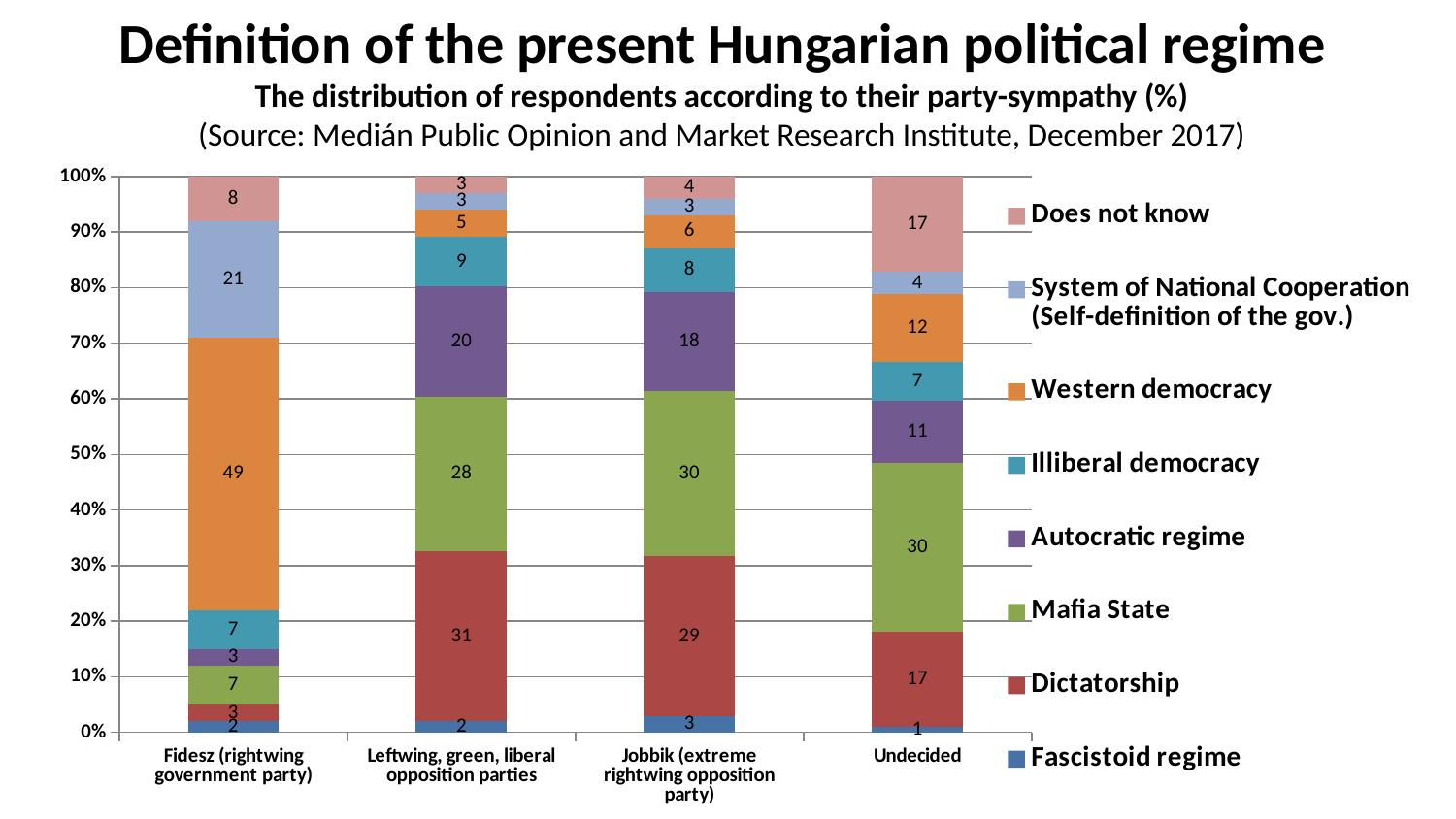
Which is larger: the Dictatorship value for Jobbik (extreme rightwing opposition party) or for Undecided? Jobbik (extreme rightwing opposition party) What kind of chart is shown on the slide? Stacked bar chart Which legend entry is shown in green? Mafia State Which category has the lowest value for Fascistoid regime? Undecided What is the value for Dictatorship among Leftwing, green, liberal opposition parties respondents? 31 What is the value for Does not know among Undecided respondents? 17 How many series does the legend list? 8 What is the difference between the Autocratic regime values for Leftwing, green, liberal opposition parties and Undecided? 9 Which category has the highest value for System of National Cooperation (Self-definition of the gov.)? Fidesz (rightwing government party) What is the value for Mafia State among Jobbik (extreme rightwing opposition party) respondents? 30 What is the value for Western democracy among Fidesz (rightwing government party) respondents? 49 How many party-sympathy categories are shown on the x axis? 4